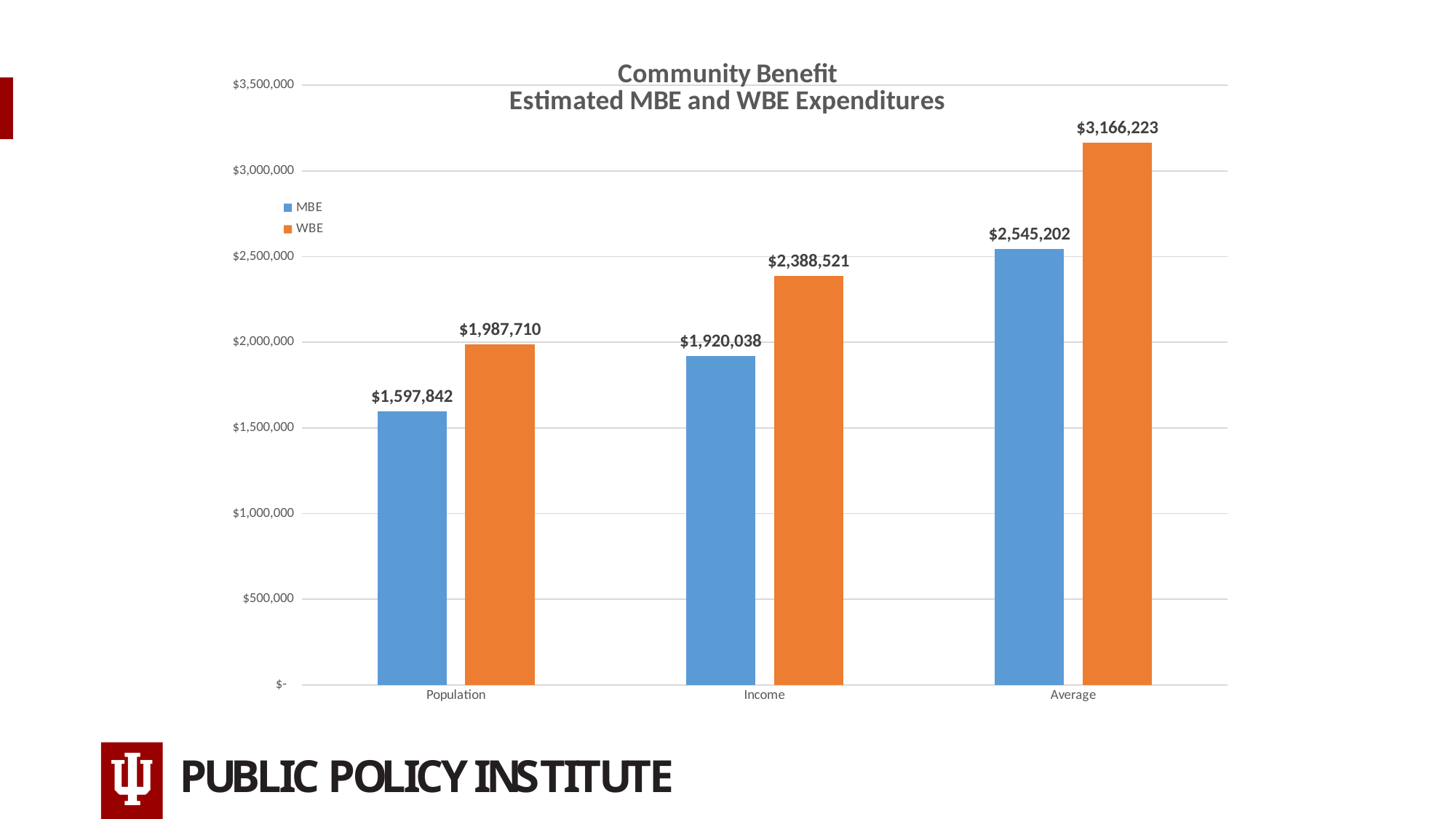
What is the difference between the WBE and MBE values for Average? $621,021 How many series does the legend list? 2 What is the difference between the WBE and MBE values for Income? $468,483 What is the WBE value for Average? $3,166,223 Which category has the highest MBE value? Average What is the MBE value for Population? $1,597,842 Which is larger for Population, the MBE value or the WBE value? WBE What kind of chart is shown on the slide? bar chart What is the WBE value for Income? $2,388,521 Is the MBE value for Income greater or less than $2,000,000? less Which category has the lowest WBE value? Population How many categories are shown on the x axis? 3